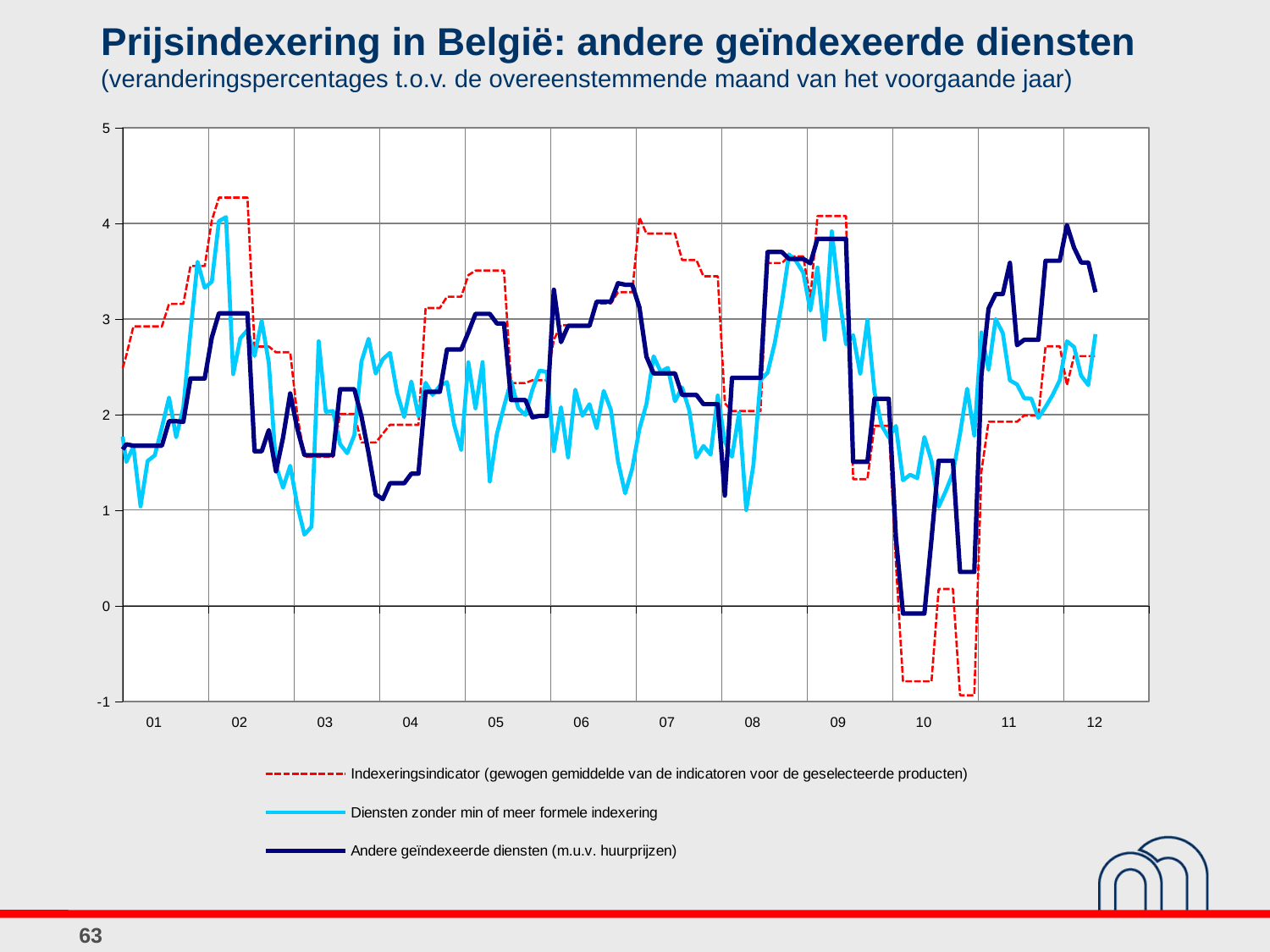
Is the highest value reached by the Indexeringsindicator series greater or less than 4? greater How many year labels are shown on the x axis? 12 Which series is drawn as a red dashed line? Indexeringsindicator (gewogen gemiddelde van de indicatoren voor de geselecteerde producten) Is the lowest value reached by the Indexeringsindicator series greater or less than 0? less Does the Indexeringsindicator series rise or fall between 07 and 08? fall What kind of chart is shown on the slide? line chart How many series does the legend list? 3 Which series reaches the lowest value anywhere on the chart? Indexeringsindicator Is the lowest value reached by the 'Andere geïndexeerde diensten (m.u.v. huurprijzen)' series greater or less than 1? less Does the 'Andere geïndexeerde diensten (m.u.v. huurprijzen)' series rise or fall between 10 and 11? rise What is the title of the chart on the slide? Prijsindexering in België: andere geïndexeerde diensten